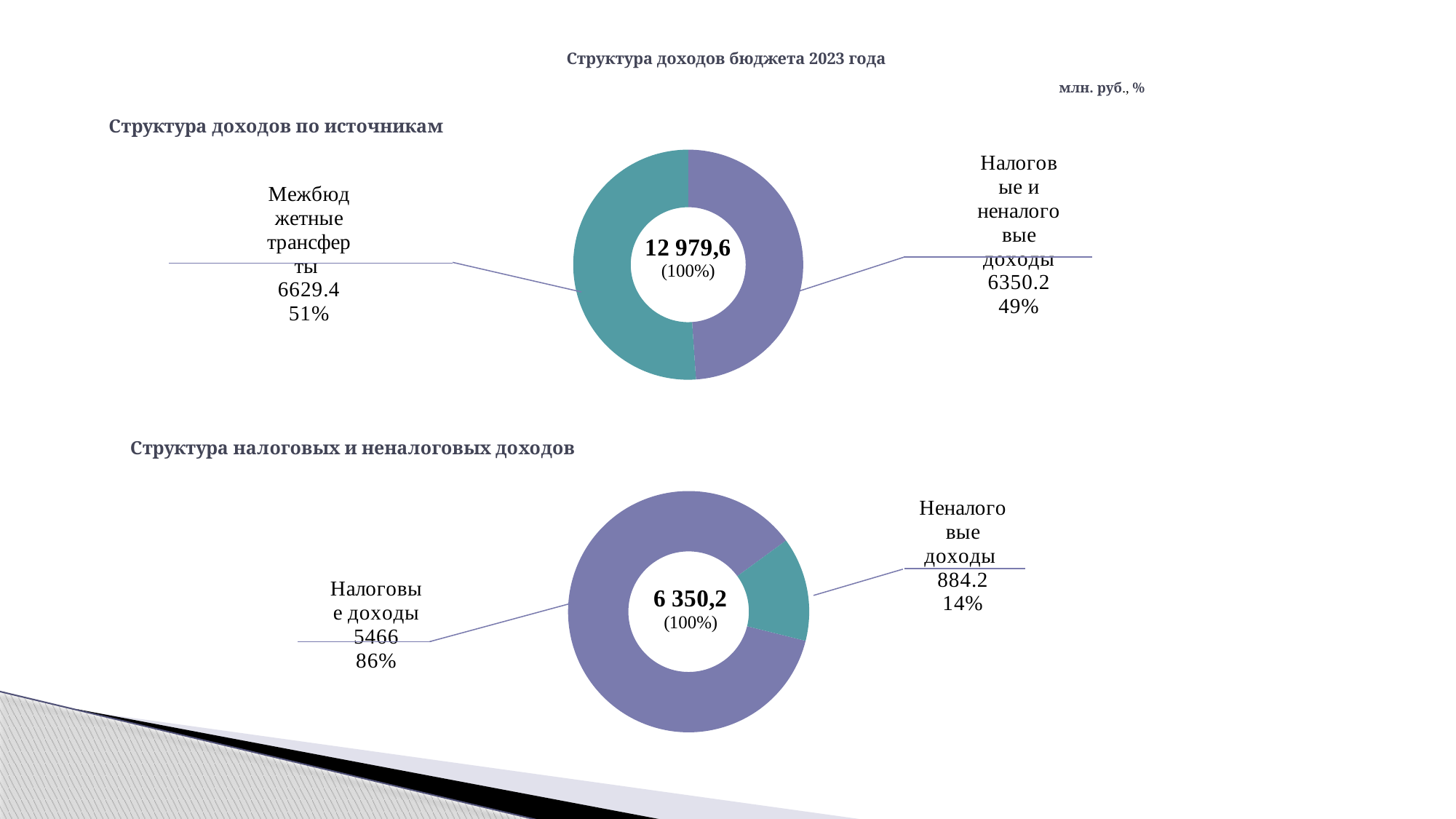
In the bottom chart 'Структура налоговых и неналоговых доходов', what total is shown in the centre of the donut? 6 350,2 In the top chart 'Структура доходов по источникам', what share of the total do Налоговые и неналоговые доходы make up? 49% In the top chart 'Структура доходов по источникам', what is the value for Межбюджетные трансферты? 6629.4 In the bottom chart 'Структура налоговых и неналоговых доходов', what share of the total do Налоговые доходы make up? 86% What kind of chart is the top chart 'Структура доходов по источникам'? Donut (pie) chart In the bottom chart 'Структура налоговых и неналоговых доходов', which is larger: Налоговые доходы or Неналоговые доходы? Налоговые доходы In the bottom chart 'Структура налоговых и неналоговых доходов', which category is the smallest? Неналоговые доходы In the bottom chart 'Структура налоговых и неналоговых доходов', what is the value for Неналоговые доходы? 884.2 How many categories does the bottom chart 'Структура налоговых и неналоговых доходов' show? 2 In the top chart 'Структура доходов по источникам', which category is the largest? Межбюджетные трансферты In the top chart 'Структура доходов по источникам', what is the difference between Межбюджетные трансферты and Налоговые и неналоговые доходы? 279.2 In the top chart 'Структура доходов по источникам', what total is shown in the centre of the donut? 12 979,6